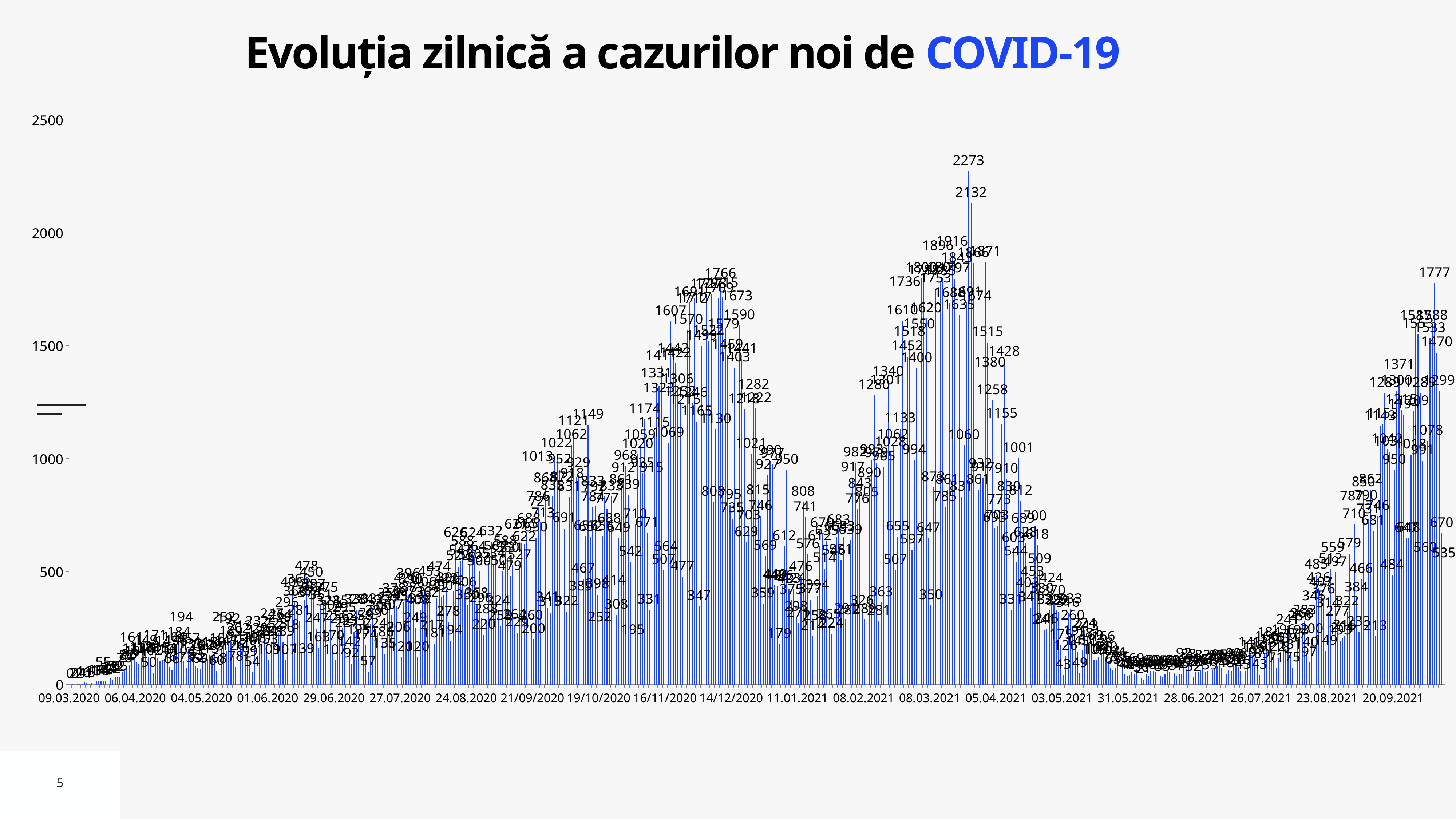
Is the highest bar on the chart greater or less than 2000? greater Do the values rise or fall between 26.07.2021 and 20.09.2021? rise What is the second-highest daily value labelled on the chart, just below the 2273 peak? 2132 What is the maximum value shown on the y axis? 2500 Do the values rise or fall between 05.04.2021 and 31.05.2021? fall What is the difference between the two highest labelled values, 2273 and 2132? 141 What is the title of the chart? Evoluția zilnică a cazurilor noi de COVID-19 Are the bars around 31.05.2021 greater or less than 500? less Which is larger: the peak value of 2273 in April 2021 or the peak value of 1777 near the end of the chart? 2273 What is the first date label on the x axis? 09.03.2020 What is the highest daily value labelled on the chart? 2273 What kind of chart is shown on the slide? bar chart